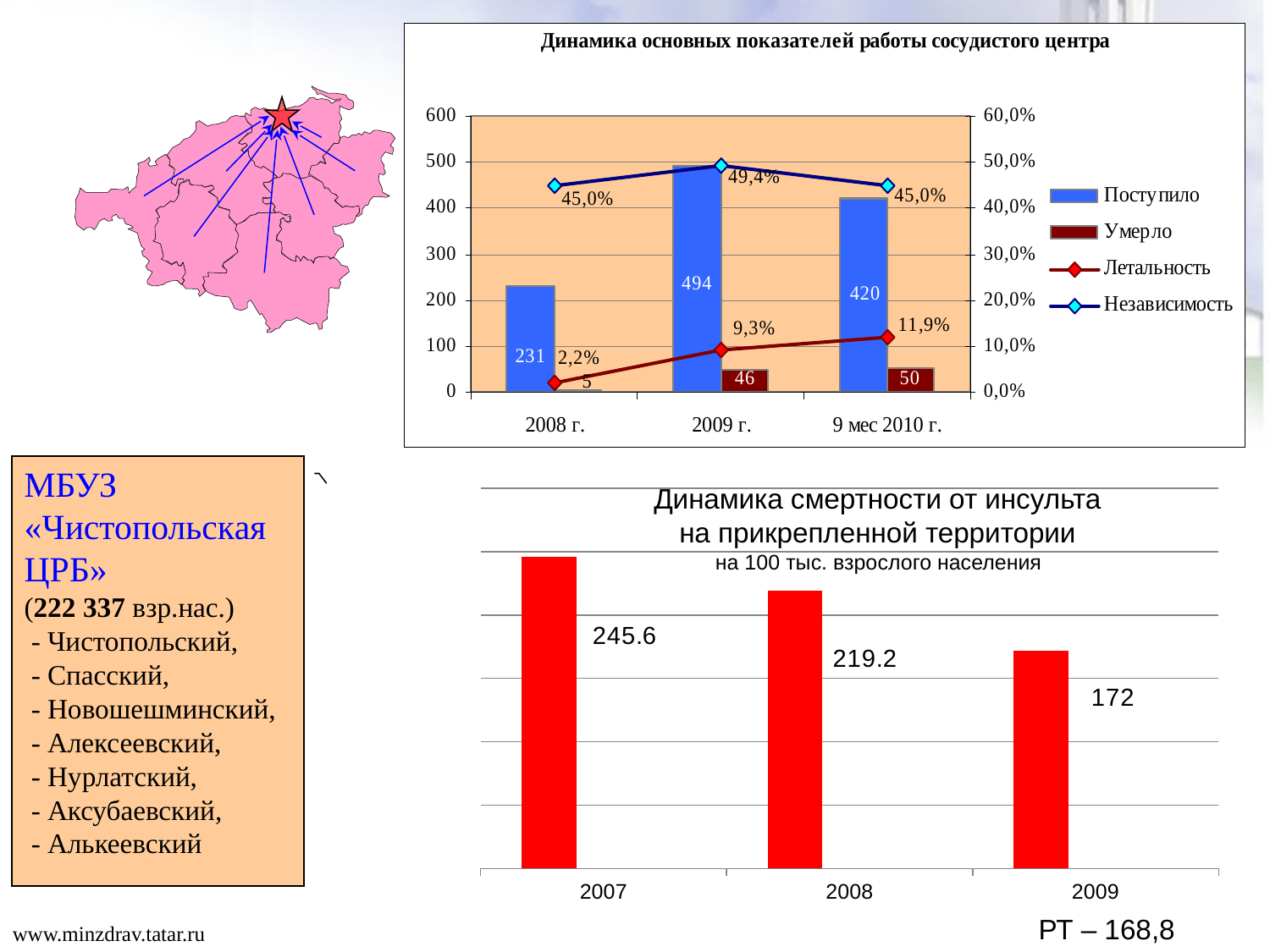
In the chart 'Динамика основных показателей работы сосудистого центра', what is the value of 'Умерло' for 9 мес 2010 г.? 50 In the chart 'Динамика основных показателей работы сосудистого центра', what is the value of 'Поступило' for 2009 г.? 494 In the chart 'Динамика основных показателей работы сосудистого центра', what is the 'Независимость' value for 2009 г.? 49,4% In the chart 'Динамика основных показателей работы сосудистого центра', what is the difference between 'Поступило' in 2009 г. and 2008 г.? 263 In the chart 'Динамика основных показателей работы сосудистого центра', does 'Летальность' rise or fall from 2008 г. to 9 мес 2010 г.? rise In the chart 'Динамика основных показателей работы сосудистого центра', what is the 'Летальность' value for 2008 г.? 2,2% In the chart 'Динамика смертности от инсульта на прикрепленной территории', what is the difference between the 2007 and 2009 values? 73.6 In the chart 'Динамика основных показателей работы сосудистого центра', which period has the highest 'Поступило' value? 2009 г. In the chart 'Динамика основных показателей работы сосудистого центра', how many series does the legend list? 4 In the chart 'Динамика смертности от инсульта на прикрепленной территории', which year has the lowest value? 2009 In the chart 'Динамика смертности от инсульта на прикрепленной территории', what is the value for 2008? 219.2 What kind of chart is 'Динамика смертности от инсульта на прикрепленной территории'? bar chart